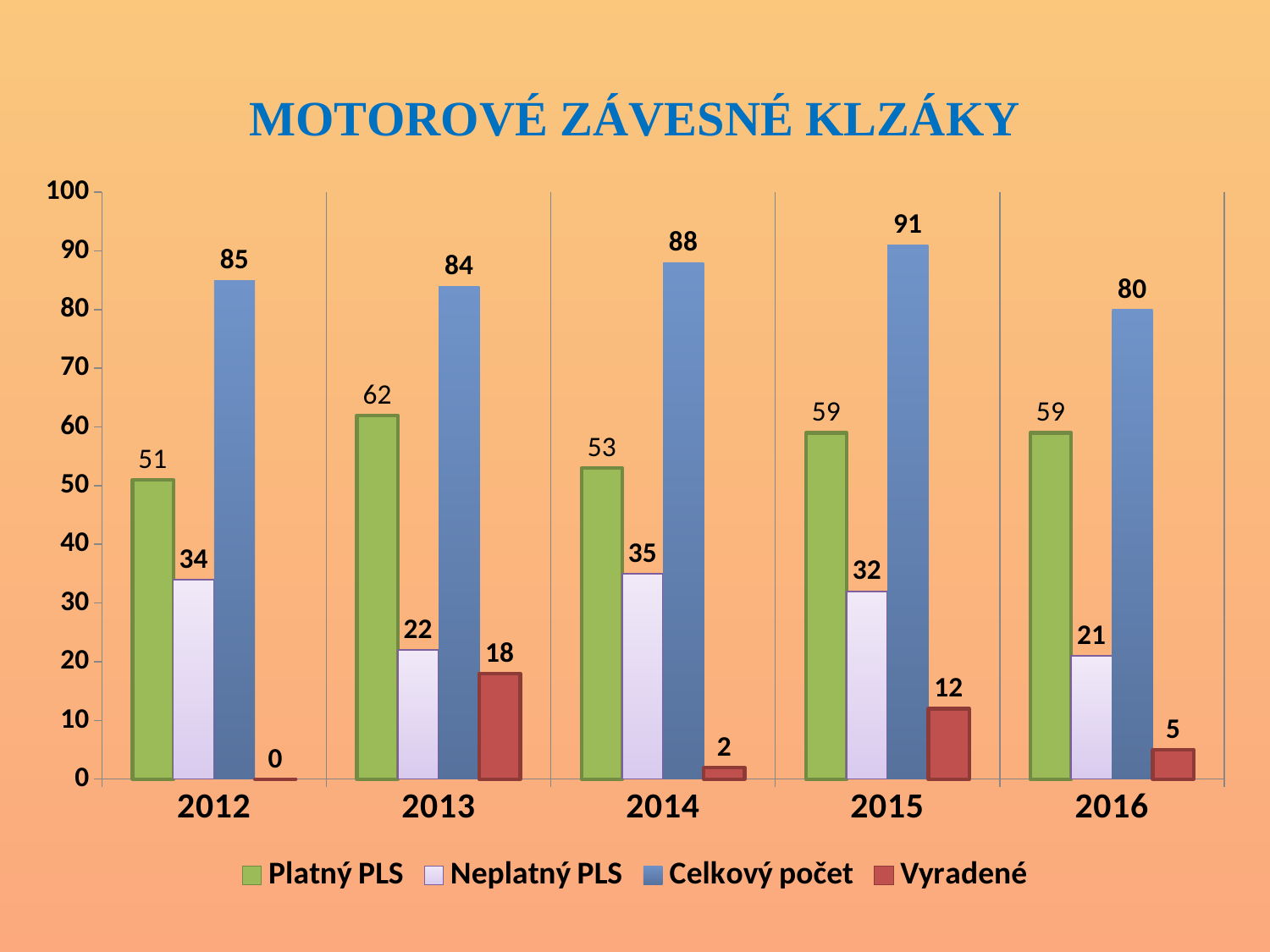
What is the value of Celkový počet for 2015? 91 In which year is Celkový počet highest? 2015 What kind of chart is shown on the slide? Bar chart Which is larger in 2013: Neplatný PLS or Vyradené? Neplatný PLS What is the value of Vyradené for 2012? 0 How many series does the legend list? 4 In which year is Vyradené lowest? 2012 What is the title of the chart? MOTOROVÉ ZÁVESNÉ KLZÁKY What is the difference between Celkový počet and Platný PLS in 2014? 35 How many years are shown on the x axis? 5 What is the value of Neplatný PLS for 2016? 21 What is the value of Platný PLS for 2013? 62